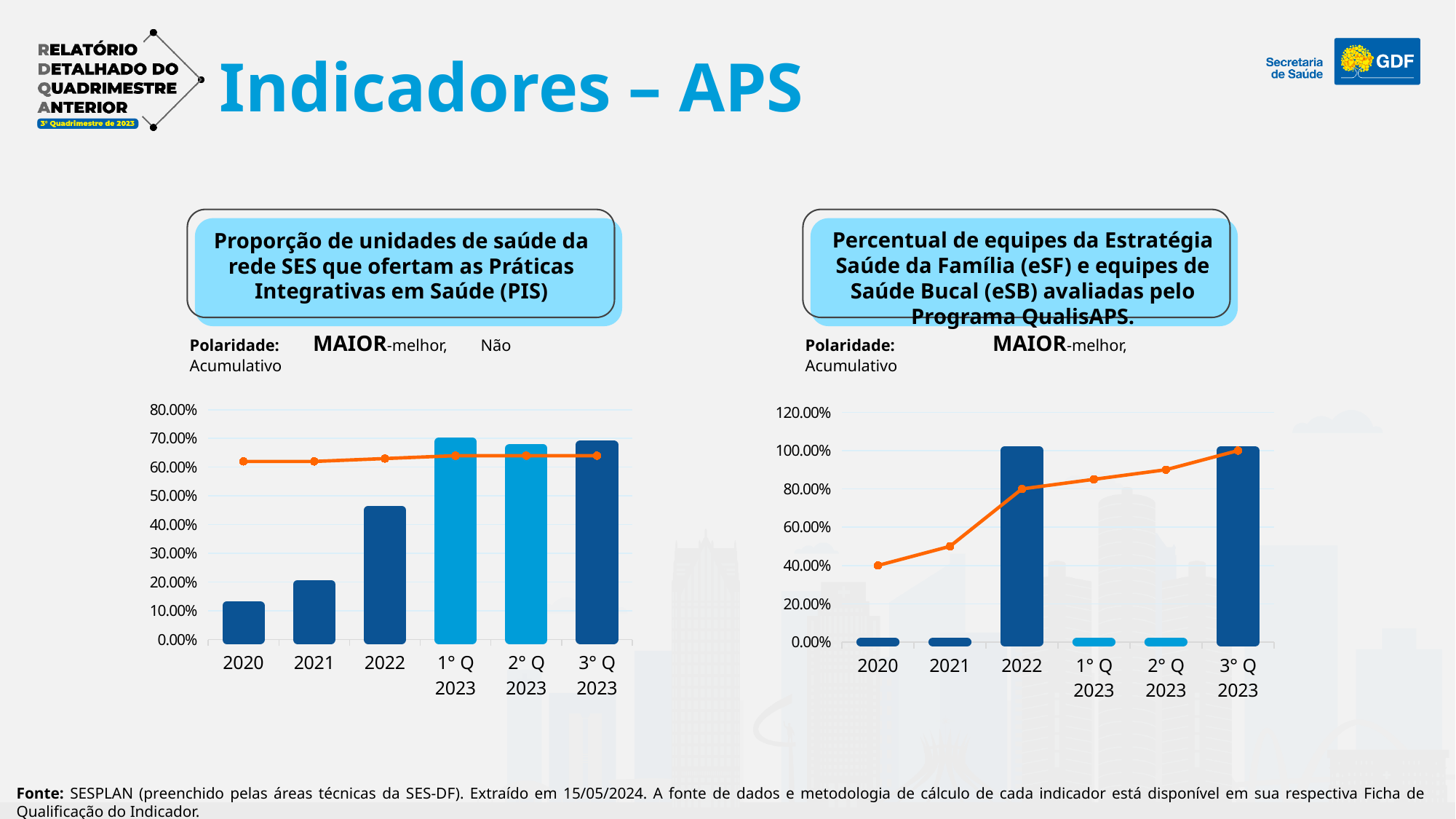
On the left chart (Proporção de unidades de saúde da rede SES que ofertam as PIS), which category has the lowest bar? 2020 On the left chart (Proporção de unidades de saúde da rede SES que ofertam as PIS), do the bars rise or fall from 2020 to 1° Q 2023? rise On the left chart (Proporção de unidades de saúde da rede SES que ofertam as PIS), is the bar for 2022 greater or less than 40.00%? greater On the right chart (Percentual de equipes avaliadas pelo Programa QualisAPS), is the orange line point for 2020 greater or less than 60.00%? less On the left chart (Proporção de unidades de saúde da rede SES que ofertam as PIS), which bar is taller, 2021 or 2022? 2022 On the right chart (Percentual de equipes avaliadas pelo Programa QualisAPS), which bar is taller, 2021 or 2022? 2022 On the left chart (Proporção de unidades de saúde da rede SES que ofertam as Práticas Integrativas em Saúde), how many categories are shown on the x axis? 6 On the right chart (Percentual de equipes da Estratégia Saúde da Família e equipes de Saúde Bucal avaliadas pelo Programa QualisAPS), is the bar for 2022 greater or less than 80.00%? greater What kind of chart is the left chart (Proporção de unidades de saúde da rede SES que ofertam as PIS)? bar chart with a line On the right chart (Percentual de equipes avaliadas pelo Programa QualisAPS), does the orange line rise or fall from 2020 to 3° Q 2023? rise